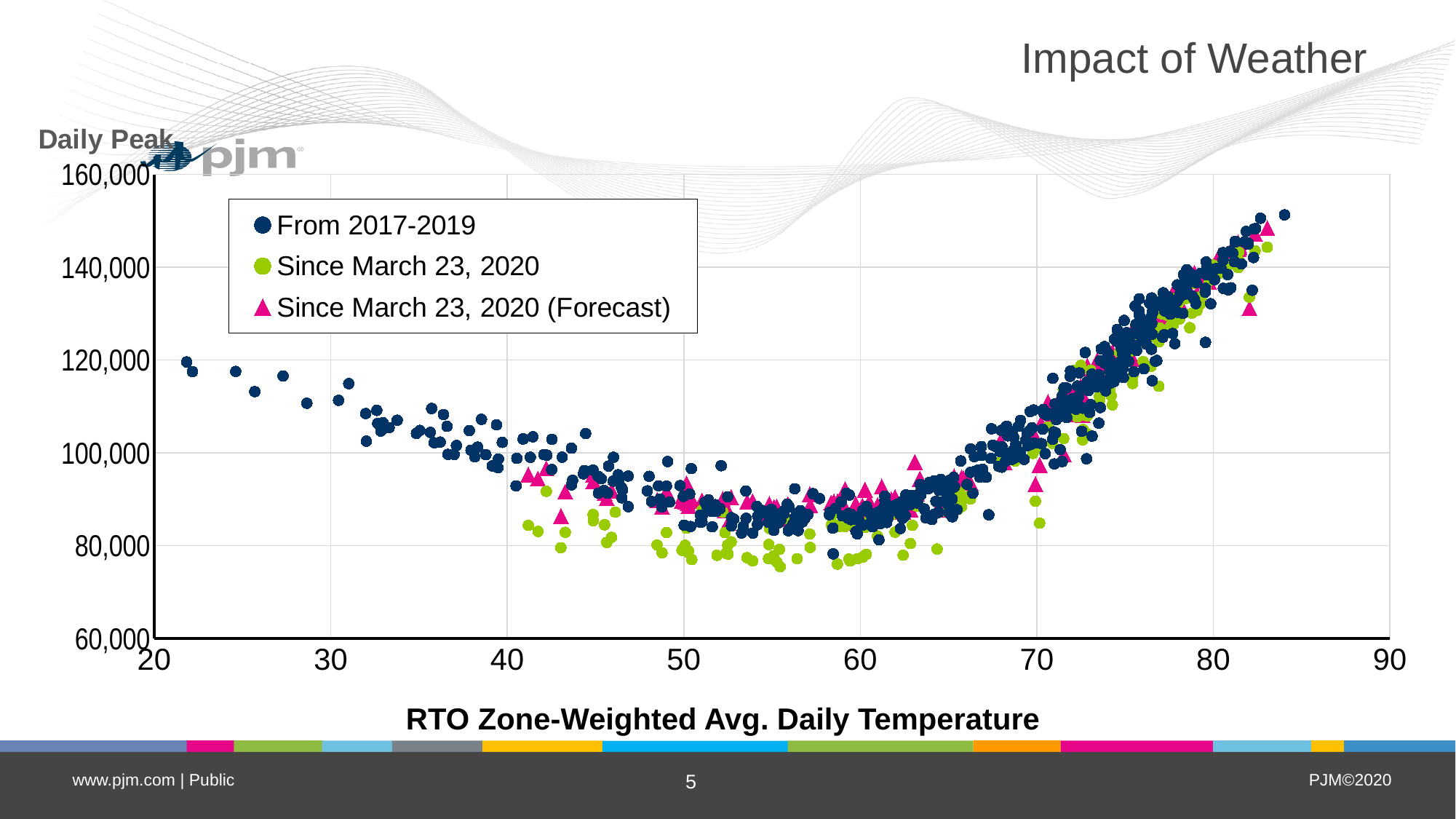
Which marker shape is used for the 'Since March 23, 2020 (Forecast)' series? Triangle Is the highest plotted value for 'From 2017-2019' greater or less than 140,000? greater Which series reaches the highest value on the chart? From 2017-2019 What is the title of the x axis? RTO Zone-Weighted Avg. Daily Temperature How many series does the legend list? 3 Is the lowest plotted value for 'Since March 23, 2020' greater or less than 80,000? less Between 70 and 85 on the x axis, do the plotted values rise or fall as temperature increases? Rise Around 55 on the x axis, which series has the lower values: 'From 2017-2019' or 'Since March 23, 2020'? Since March 23, 2020 Is the highest plotted value for 'Since March 23, 2020' greater or less than 160,000? less Between 20 and 50 on the x axis, do the 'From 2017-2019' values rise or fall as temperature increases? Fall What kind of chart is shown on the slide? Scatter chart